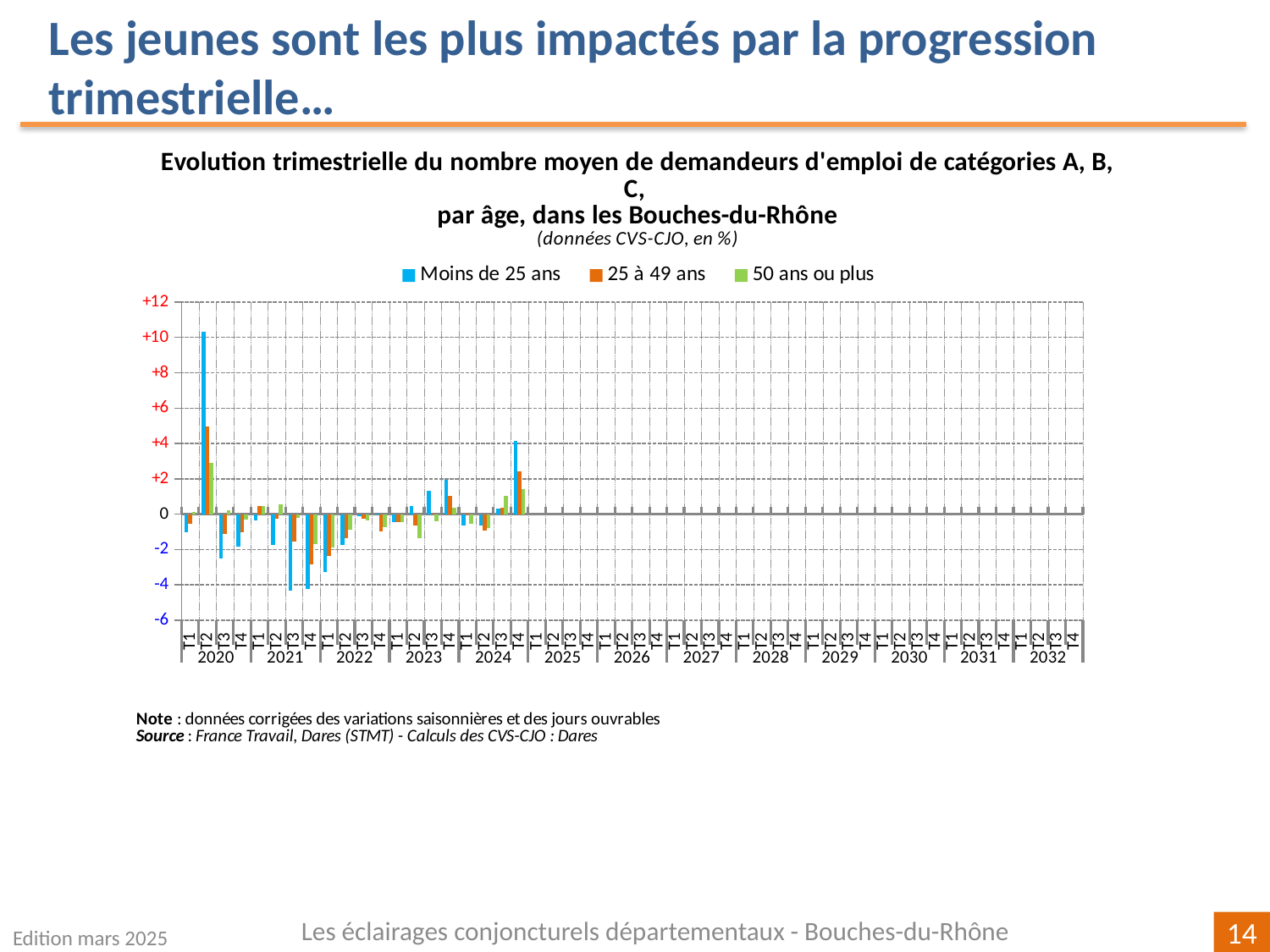
Is the value for 'Moins de 25 ans' in T2 2020 greater or less than +8? greater What kind of chart is shown on the slide? Bar chart What unit is indicated in the chart subtitle in parentheses? (données CVS-CJO, en %) How many series does the legend list? 3 How many years are labelled along the x axis? 13 Is the value for 'Moins de 25 ans' in T3 2021 greater or less than -2? less Which series has the highest value in T2 2020? Moins de 25 ans Is the value for '25 à 49 ans' in T2 2020 greater or less than +4? greater Which series is shown in blue in the legend? Moins de 25 ans In T4 2024, which is larger: the value for 'Moins de 25 ans' or for '25 à 49 ans'? Moins de 25 ans Which series has the lowest value in T2 2020? 50 ans ou plus In which quarter does the 'Moins de 25 ans' series reach its highest value? T2 2020